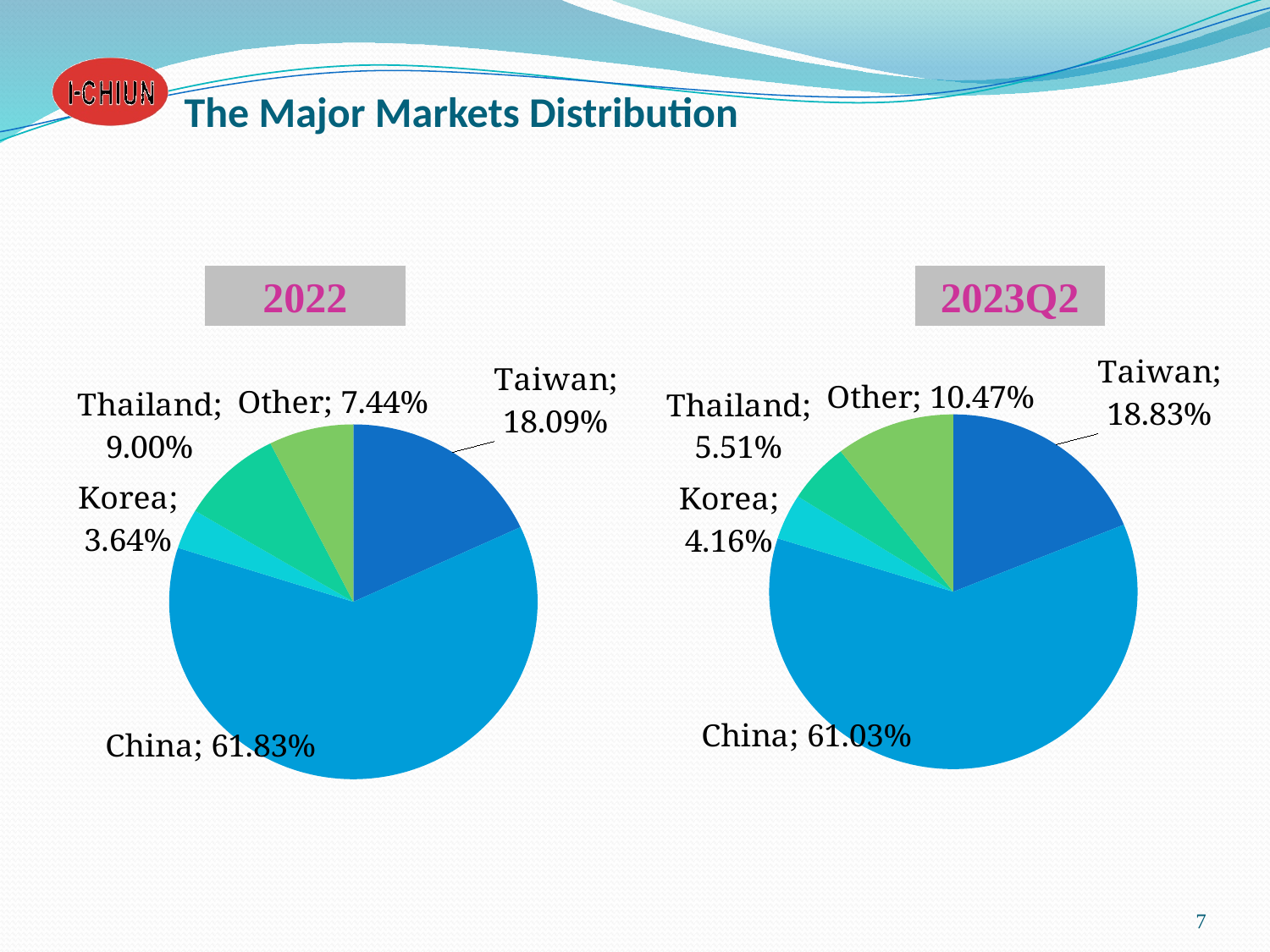
What is the title of the slide containing the two pie charts? The Major Markets Distribution In the 2023Q2 pie chart, what is the difference between China's share and Taiwan's share? 42.20% How many slices does the 2022 pie chart have? 5 What kind of chart is used for the 2023Q2 data? Pie chart In the 2023Q2 pie chart, which is larger, the share for Thailand or the share for Korea? Thailand In the 2023Q2 pie chart, which market has the smallest share? Korea In the 2022 pie chart, what share does China have? 61.83% In the 2023Q2 pie chart, what share does Taiwan have? 18.83% In the 2022 pie chart, what is the difference between Taiwan's share and Thailand's share? 9.09% In the 2023Q2 pie chart, what share does Other have? 10.47% In the 2022 pie chart, what share does Korea have? 3.64% In the 2022 pie chart, which market has the largest share? China